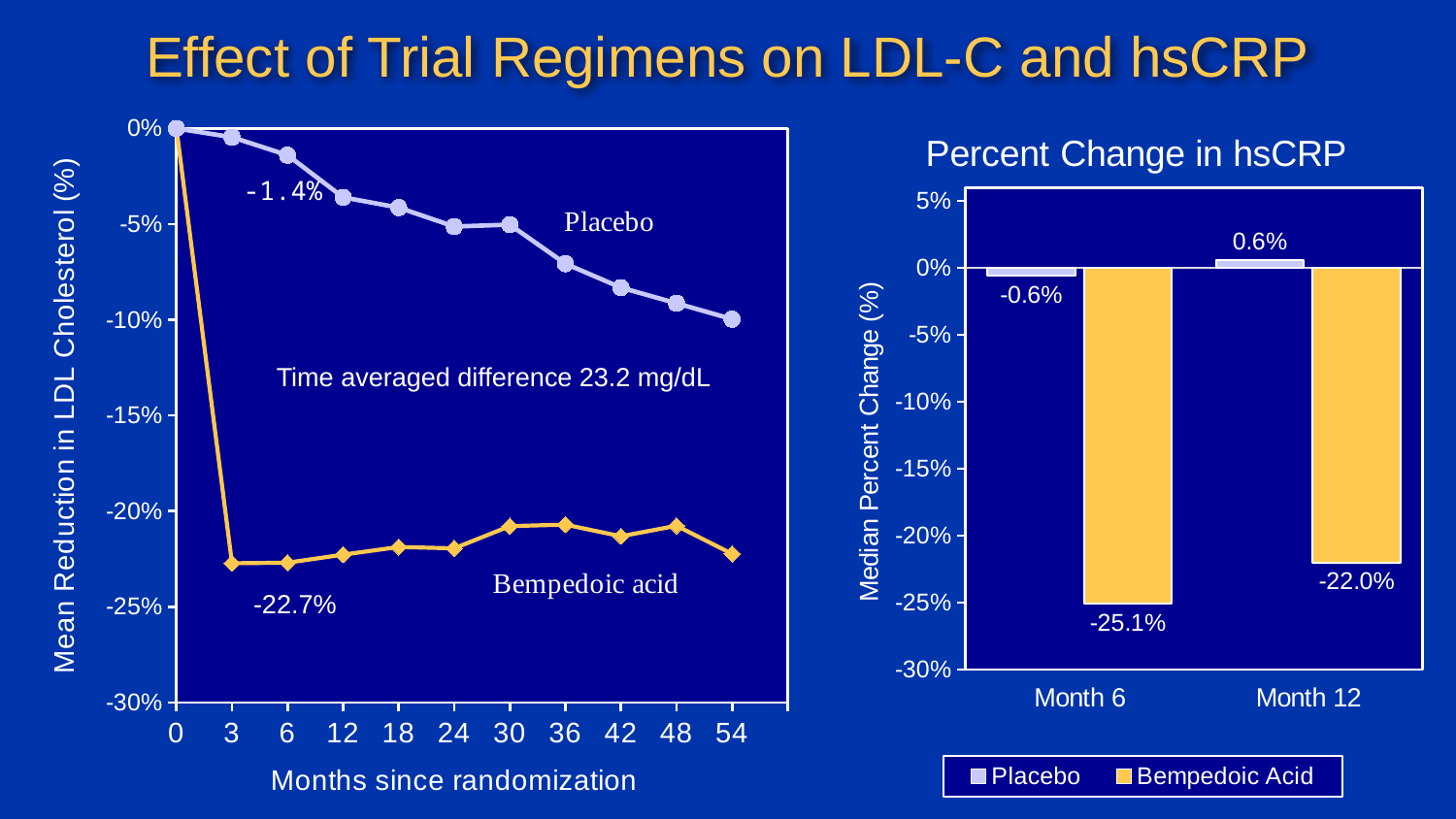
On the Percent Change in hsCRP chart, what is the value for Placebo at Month 12? 0.6% On the Percent Change in hsCRP chart, which bar has the lowest value? Bempedoic Acid at Month 6 (-25.1%) On the Percent Change in hsCRP chart, what is the value for Bempedoic Acid at Month 12? -22.0% On the Percent Change in hsCRP chart, what is the value for Placebo at Month 6? -0.6% On the Percent Change in hsCRP chart, how many series does the legend list? 2 On the Percent Change in hsCRP chart, what is the value for Bempedoic Acid at Month 6? -25.1% On the Percent Change in hsCRP chart, which is larger at Month 12, the Placebo value or the Bempedoic Acid value? Placebo On the left LDL cholesterol chart, is the Bempedoic acid value at month 54 greater or less than -20%? less On the left LDL cholesterol chart, what time averaged difference is stated? 23.2 mg/dL On the left LDL cholesterol chart, how many time points are shown on the x axis? 11 What kind of chart is the Percent Change in hsCRP chart? Bar chart On the Percent Change in hsCRP chart, what is the difference between the Placebo and Bempedoic Acid values at Month 6? 24.5 percentage points